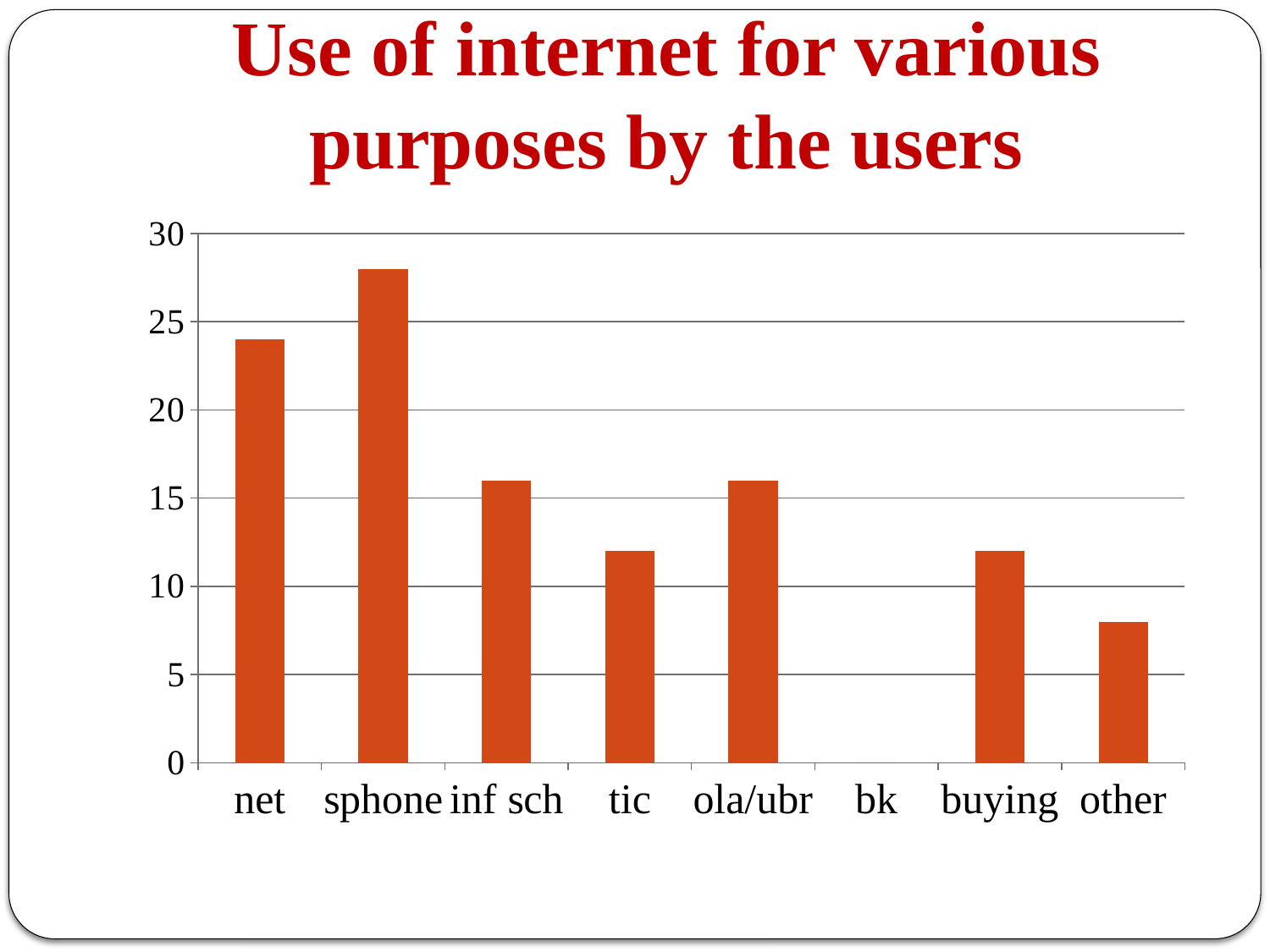
Which category has the lowest value? bk Which category has the highest value? sphone Is the value for sphone greater or less than 25? greater Is the value for other greater or less than 10? less Is the value for net greater or less than 20? greater What kind of chart is shown on the slide? bar chart Which is larger, the value for other or the value for tic? tic How many categories are shown on the x axis? 8 Which is larger, the value for net or the value for sphone? sphone What is the title of the chart? Use of internet for various purposes by the users